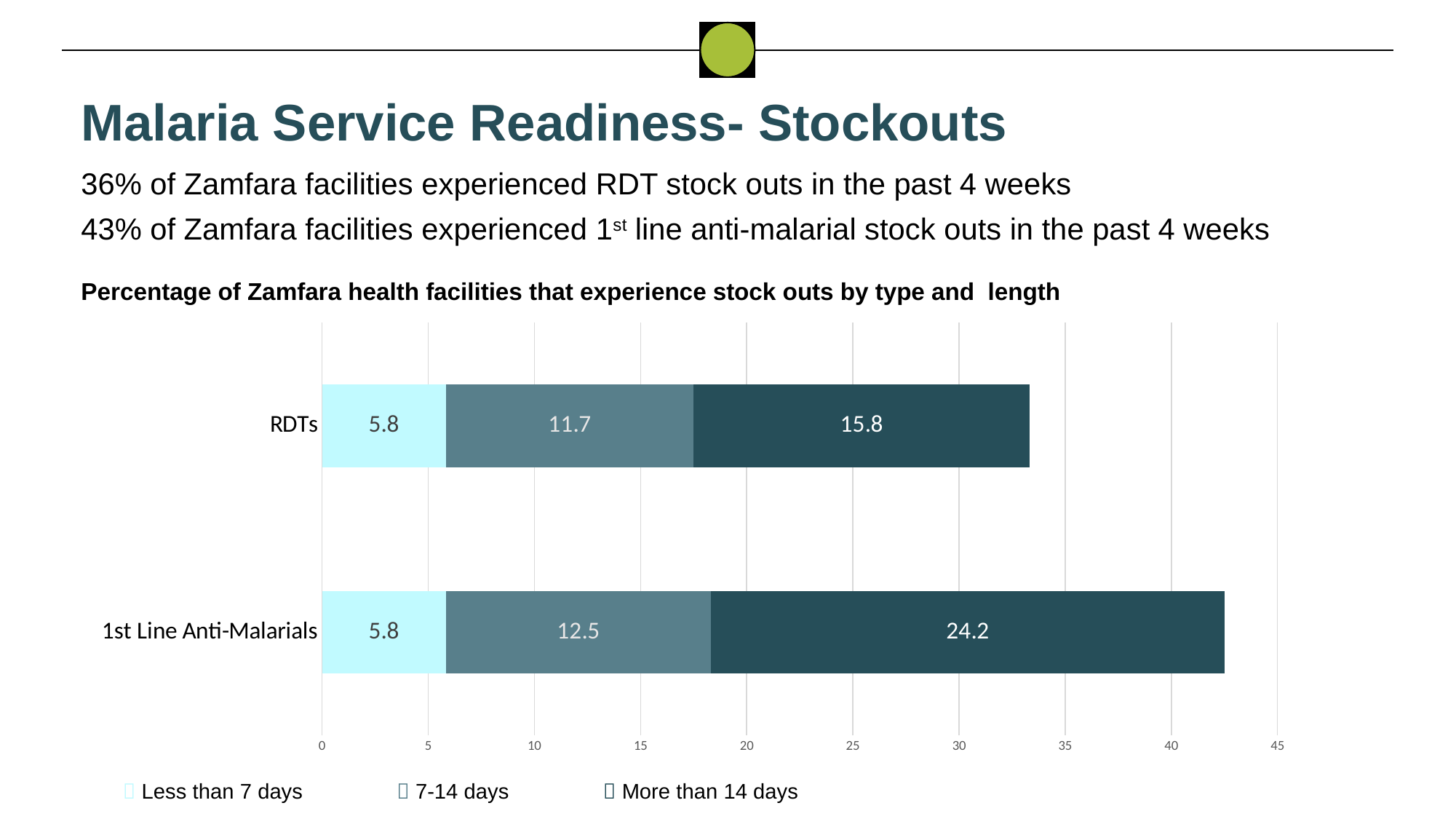
How many series does the legend list? 3 What is the value for 'More than 14 days' for 1st Line Anti-Malarials? 24.2 Which category has the larger 'More than 14 days' value, RDTs or 1st Line Anti-Malarials? 1st Line Anti-Malarials What is the difference between the 'More than 14 days' values for 1st Line Anti-Malarials and RDTs? 8.4 What is the total of the stacked bar for 1st Line Anti-Malarials? 42.5 What is the value for 'Less than 7 days' for RDTs? 5.8 What is the difference between the '7-14 days' values for 1st Line Anti-Malarials and RDTs? 0.8 What is the total of the stacked bar for RDTs? 33.3 What is the value for 'More than 14 days' for RDTs? 15.8 What kind of chart is shown on the slide? Stacked bar chart How many categories are shown on the chart? 2 What is the value for '7-14 days' for 1st Line Anti-Malarials? 12.5